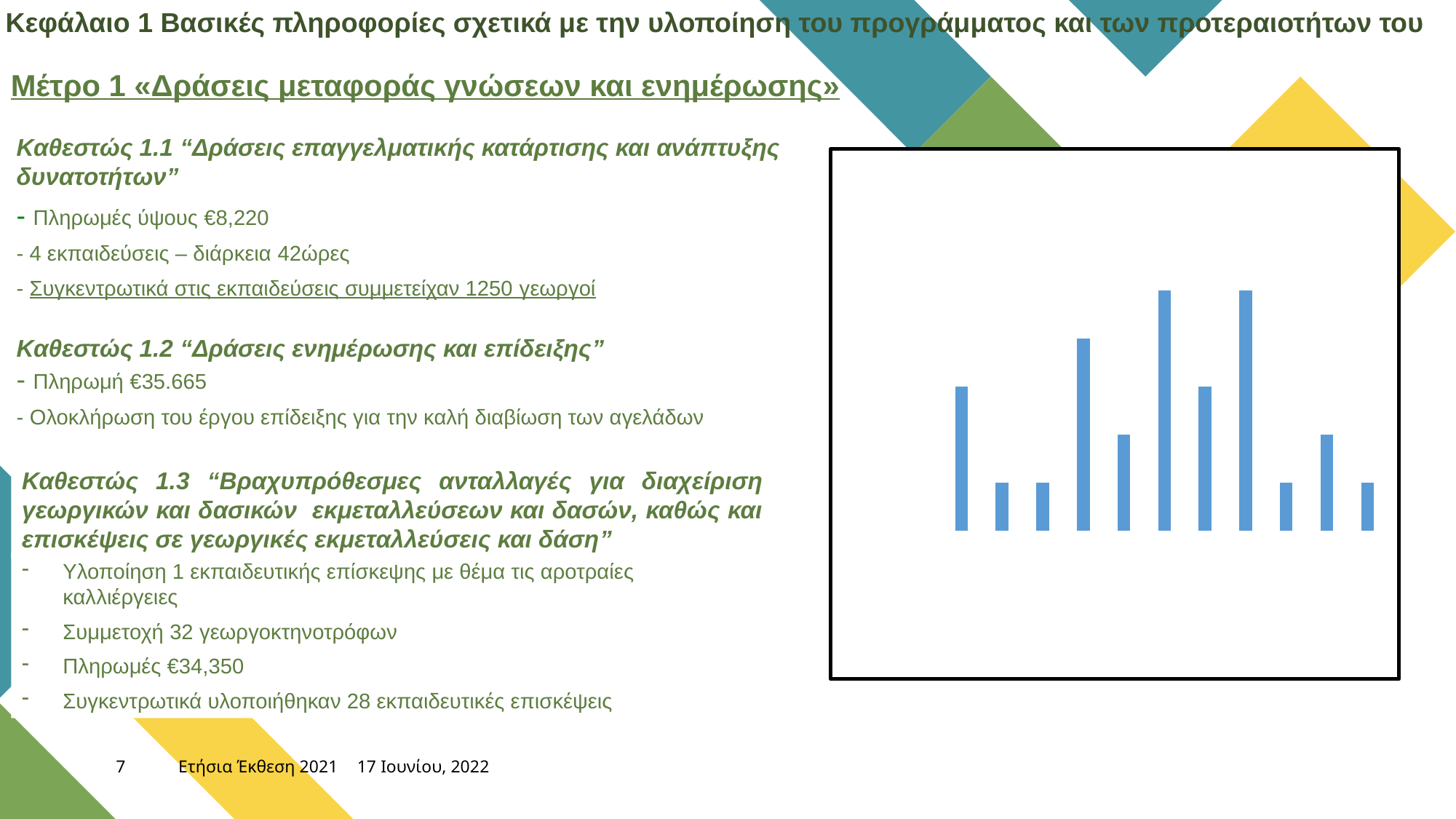
How many bars does the chart on the right side of the slide contain? 11 What kind of chart is shown on the right side of the slide? bar chart What colour are the bars in the chart on the right side of the slide? blue In the chart on the right side of the slide, is the last bar on the right taller or shorter than the second-to-last bar? shorter Does the chart on the right side of the slide display a title, axis labels or a legend? No In the chart on the right side of the slide, is the sixth bar from the left taller or shorter than the seventh bar from the left? taller In the chart on the right side of the slide, is the first bar from the left taller or shorter than the second bar from the left? taller